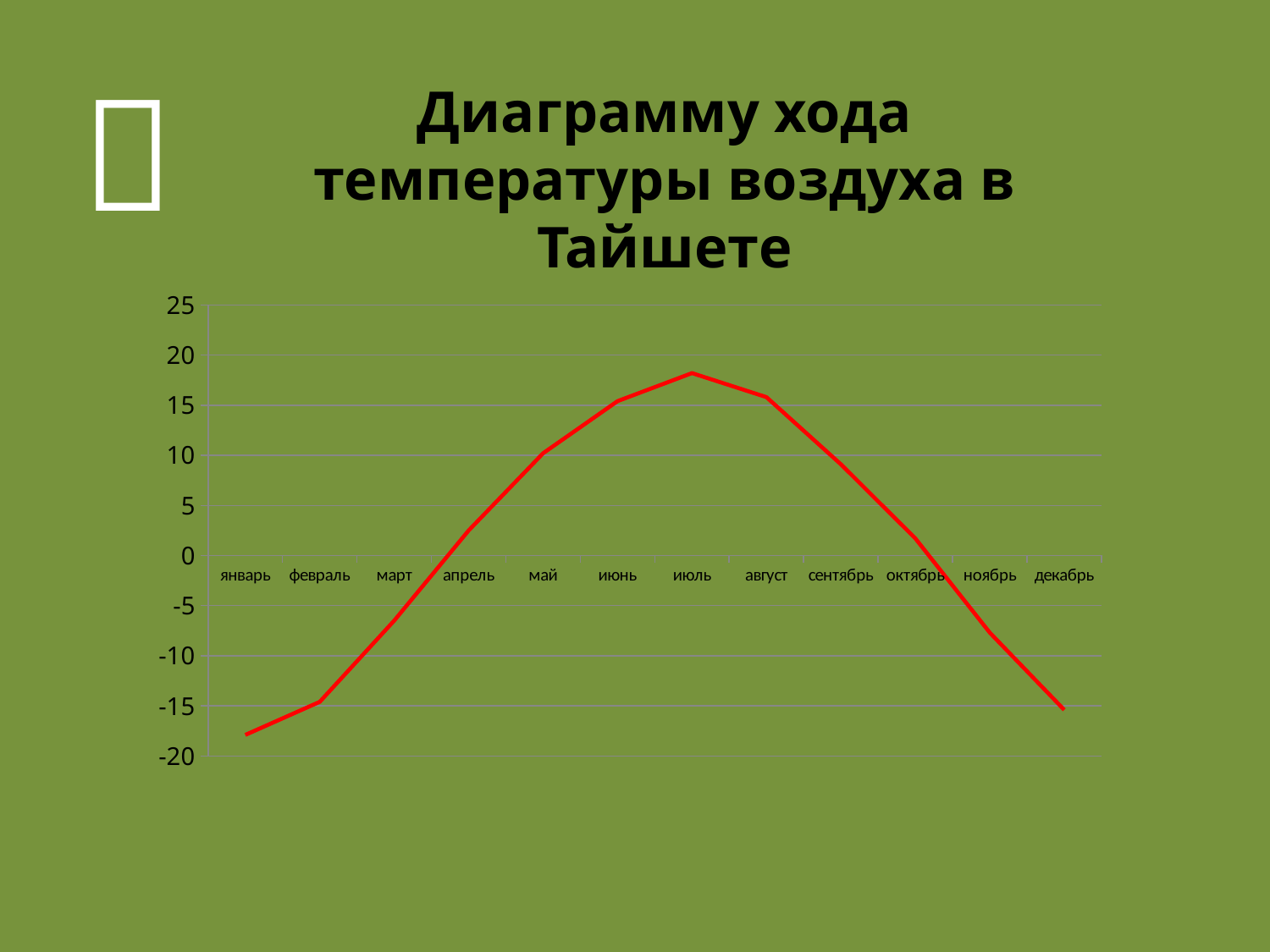
Which is larger, the value for август or the value for сентябрь? август Is the value for январь greater or less than -15? less What kind of chart is shown on the slide? line chart Which month has the lowest temperature? январь Is the value for март greater or less than -5? less What is the title of the chart on the slide? Диаграмму хода температуры воздуха в Тайшете Do the values rise or fall from январь to июль? rise Which month has the highest temperature? июль Is the value for декабрь greater or less than -10? less How many months are plotted along the x axis? 12